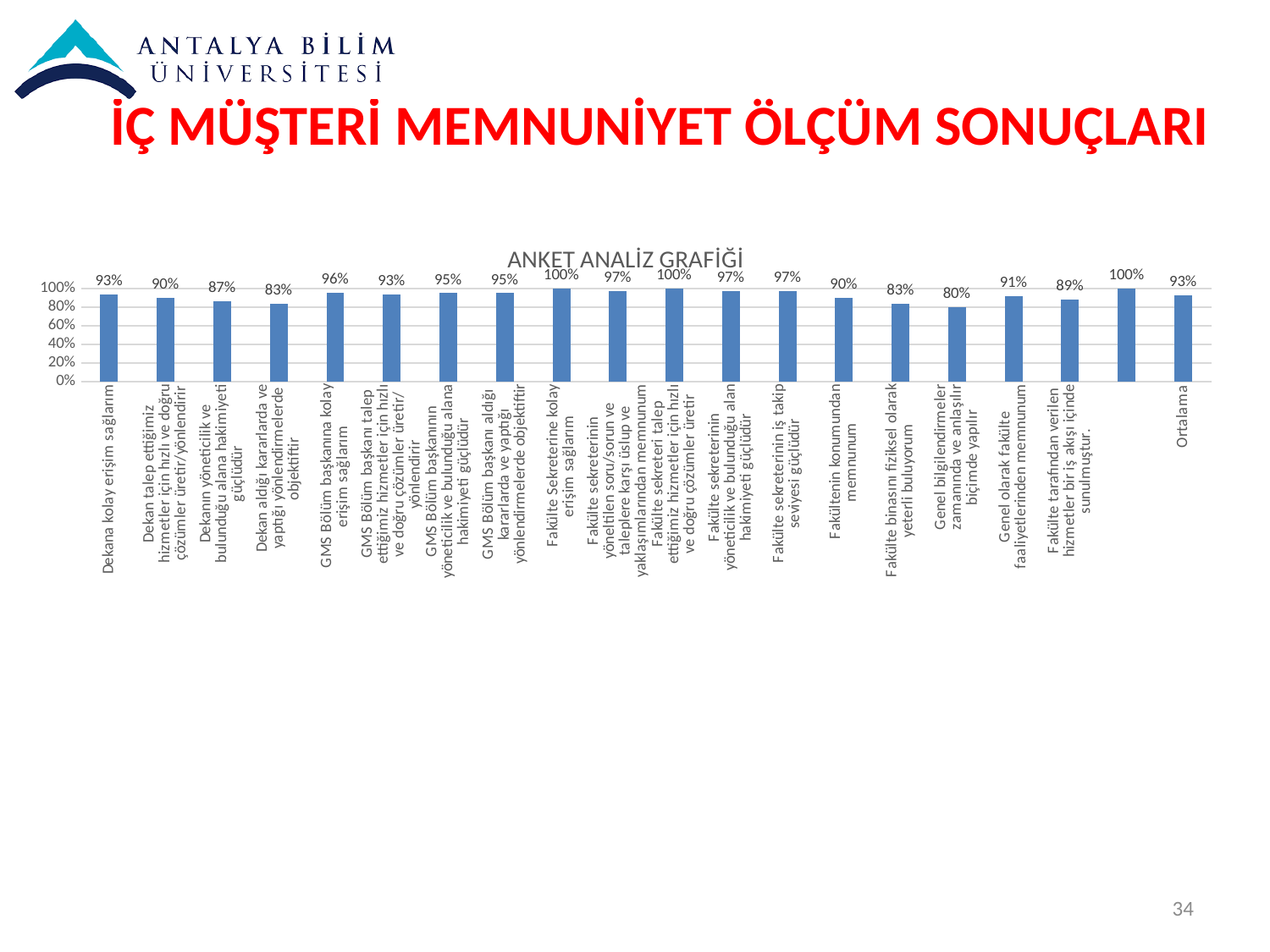
What kind of chart is shown on the slide? bar chart What is the difference between "GMS Bölüm başkanına kolay erişim sağlarım" and "Dekan aldığı kararlarda ve yaptığı yönlendirmelerde objektiftir"? 13% What is the value for "Ortalama"? 93% What is the value for "Dekanın yöneticilik ve bulunduğu alana hakimiyeti güçlüdür"? 87% What is the value for "Fakülte binasını fiziksel olarak yeterli buluyorum"? 83% Which category has the lowest value? Genel bilgilendirmeler zamanında ve anlaşılır biçimde yapılır What is the value for "Fakülte sekreterinin iş takip seviyesi güçlüdür"? 97% What is the value for "Dekana kolay erişim sağlarım"? 93% What is the value for "Fakülte Sekreterine kolay erişim sağlarım"? 100% What is the title of the chart? ANKET ANALİZ GRAFİĞİ Which is larger: the value for "Fakültenin konumundan memnunum" or the value for "Genel olarak fakülte faaliyetlerinden memnunum"? Genel olarak fakülte faaliyetlerinden memnunum What is the lowest value shown in the chart? 80%